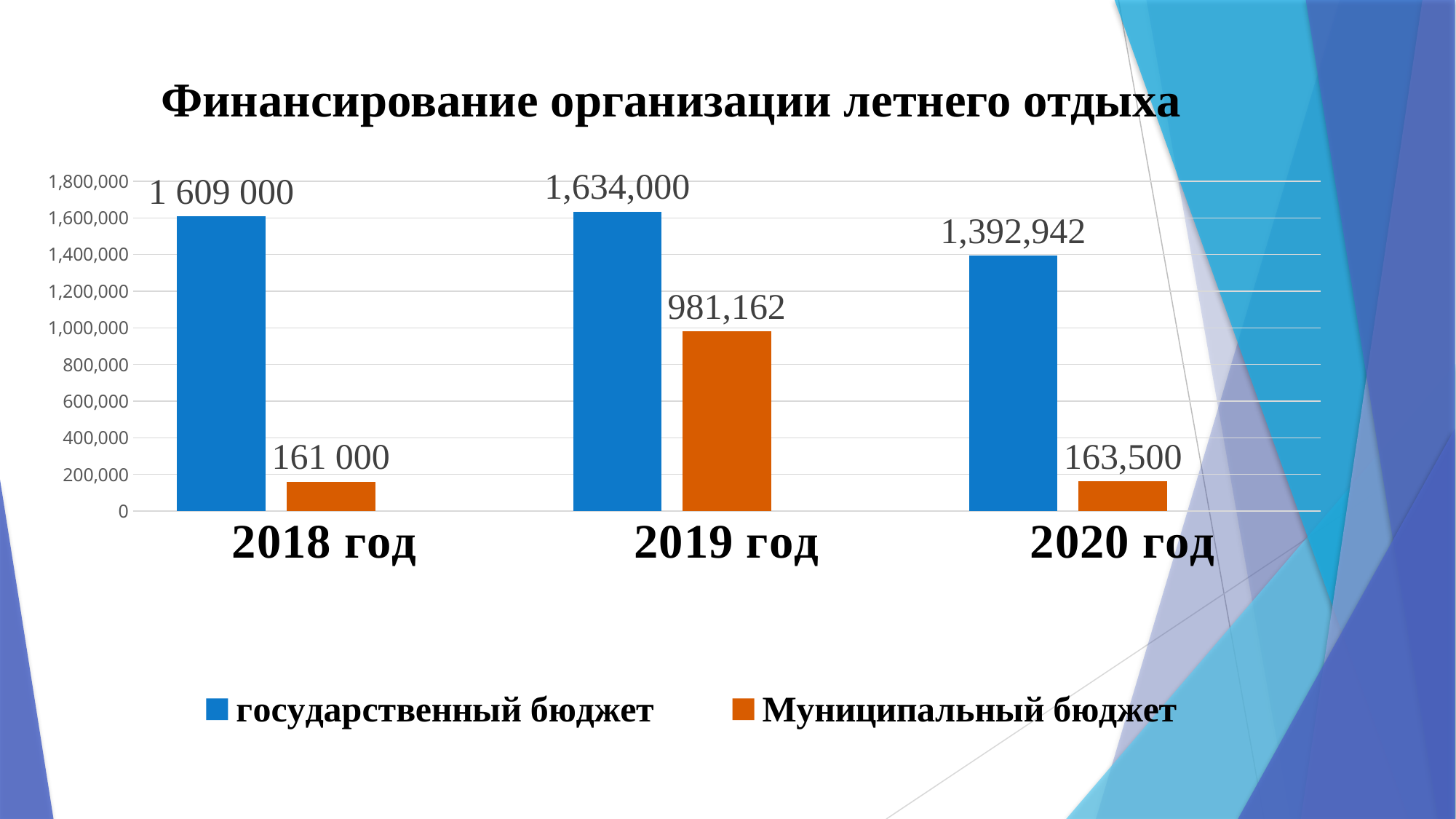
What is the difference between государственный бюджет and Муниципальный бюджет in 2019 год? 652,838 What type of chart is shown on the slide? bar chart How many series does the legend list? 2 What is the value for государственный бюджет in 2018 год? 1 609 000 Which is larger in 2020 год: государственный бюджет or Муниципальный бюджет? государственный бюджет What is the value for Муниципальный бюджет in 2020 год? 163,500 In which year is the государственный бюджет value the highest? 2019 год What is the value for Муниципальный бюджет in 2019 год? 981,162 In which year is the государственный бюджет value the lowest? 2020 год What is the value for государственный бюджет in 2020 год? 1,392,942 How many years are shown on the x axis? 3 In which year is the Муниципальный бюджет value the highest? 2019 год